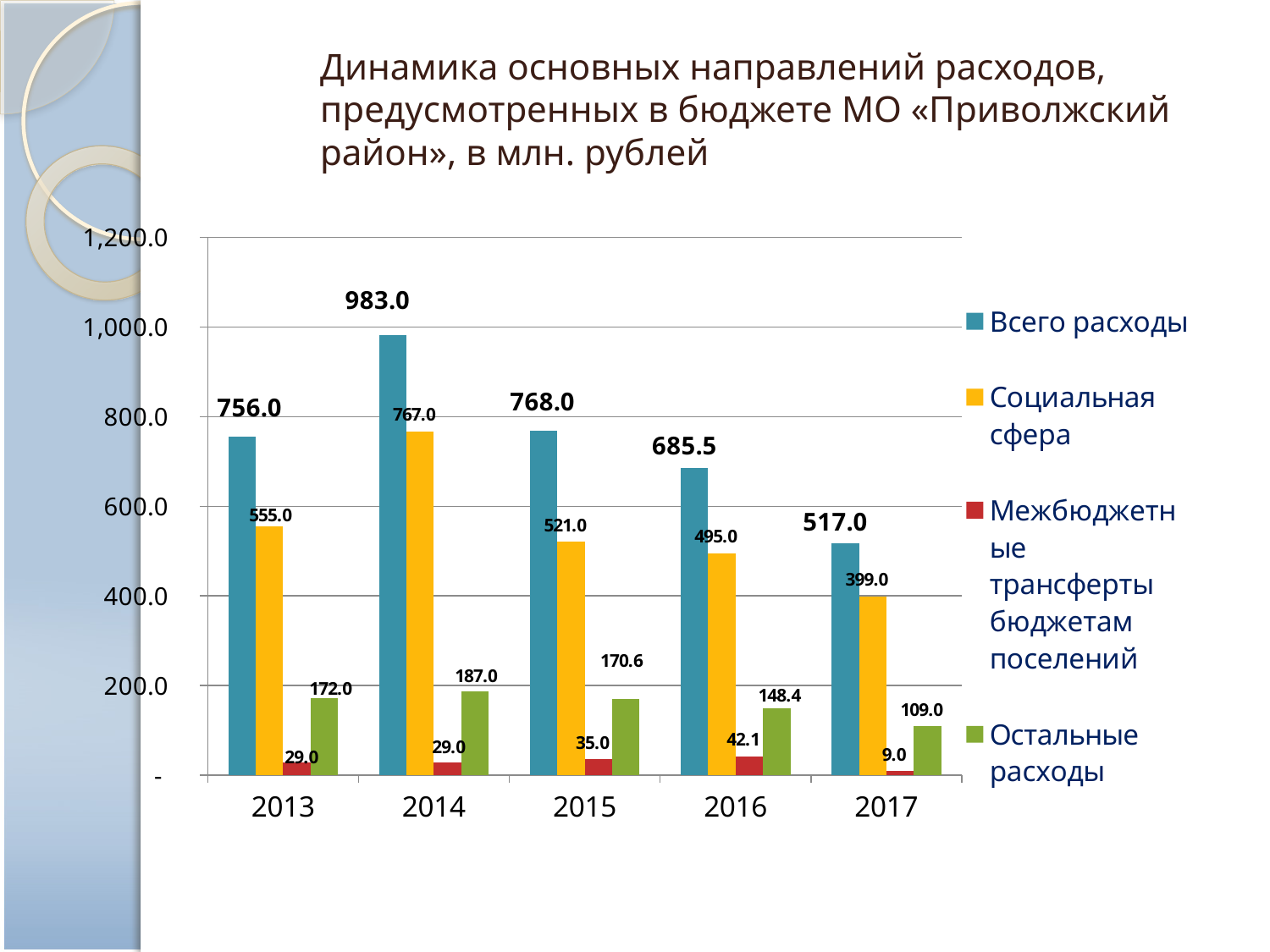
Which is larger: Социальная сфера in 2013 or in 2015? 2013 What is the value of Социальная сфера in 2017? 399.0 Is the value of Всего расходы in 2016 greater or less than 600.0? greater In which year is Межбюджетные трансферты бюджетам поселений lowest? 2017 What is the difference between Всего расходы in 2014 and in 2017? 466.0 How many series does the legend list? 4 What is the value of Межбюджетные трансферты бюджетам поселений in 2016? 42.1 What is the value of Остальные расходы in 2015? 170.6 How many years are shown on the x axis? 5 What is the value of Всего расходы in 2014? 983.0 What kind of chart is shown on the slide? bar chart In which year is Всего расходы highest? 2014